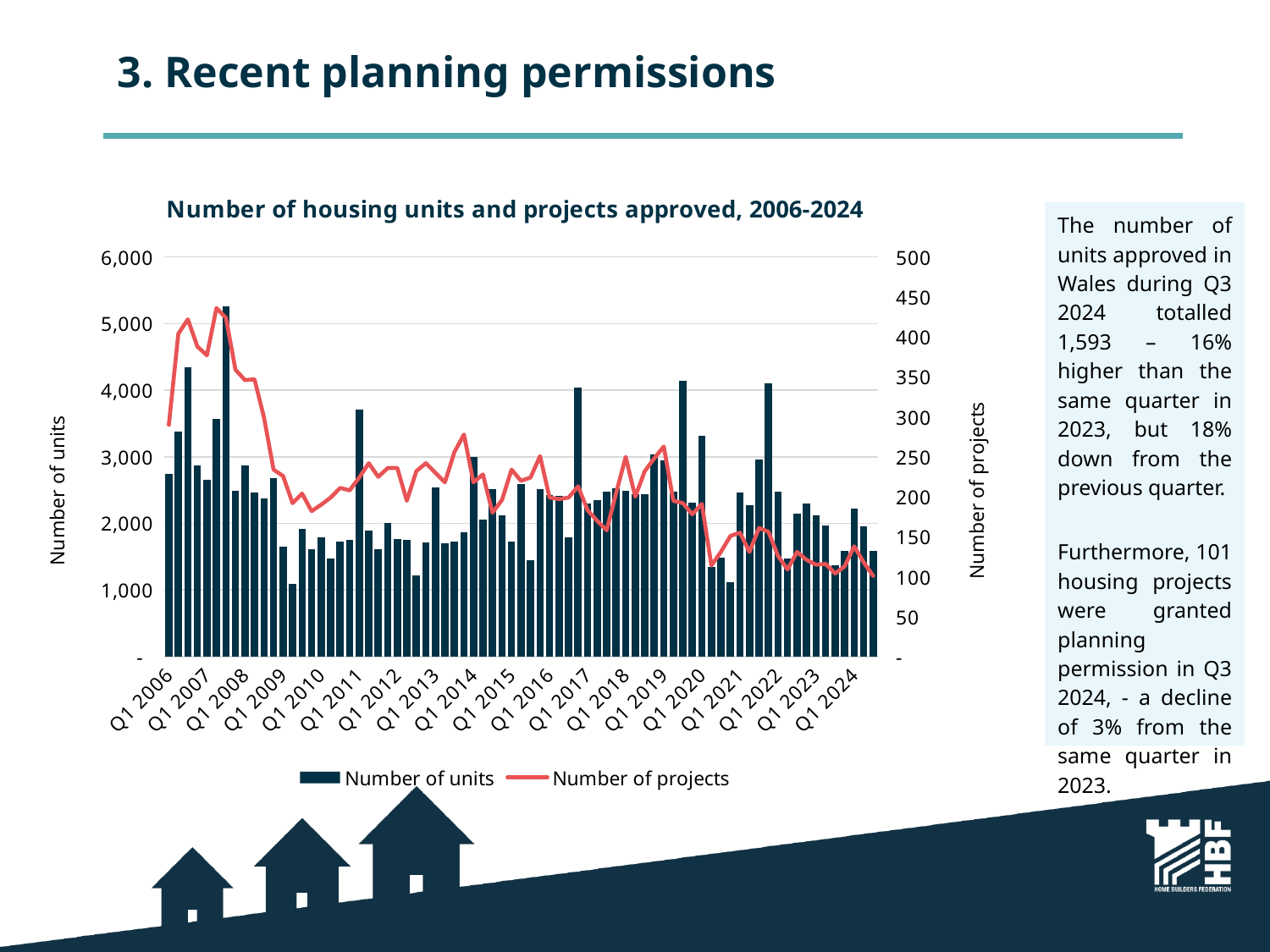
In which year does the tallest Number of units bar occur? 2007 Which is larger, the Number of units bar at Q1 2008 or at Q1 2024? Q1 2008 How many quarter labels are shown on the x axis? 19 Is the value for Number of units in Q1 2006 greater or less than 2,000? greater What type of chart is shown on the slide? Combined bar and line chart Does the Number of projects line generally rise or fall from 2006 to 2024? fall How many series does the chart legend list? 2 Is the value for Number of units in Q1 2024 greater or less than 3,000? less Is the value for Number of projects in Q1 2006 greater or less than 250? greater Which series is plotted as a red line? Number of projects What is the title of the chart? Number of housing units and projects approved, 2006-2024